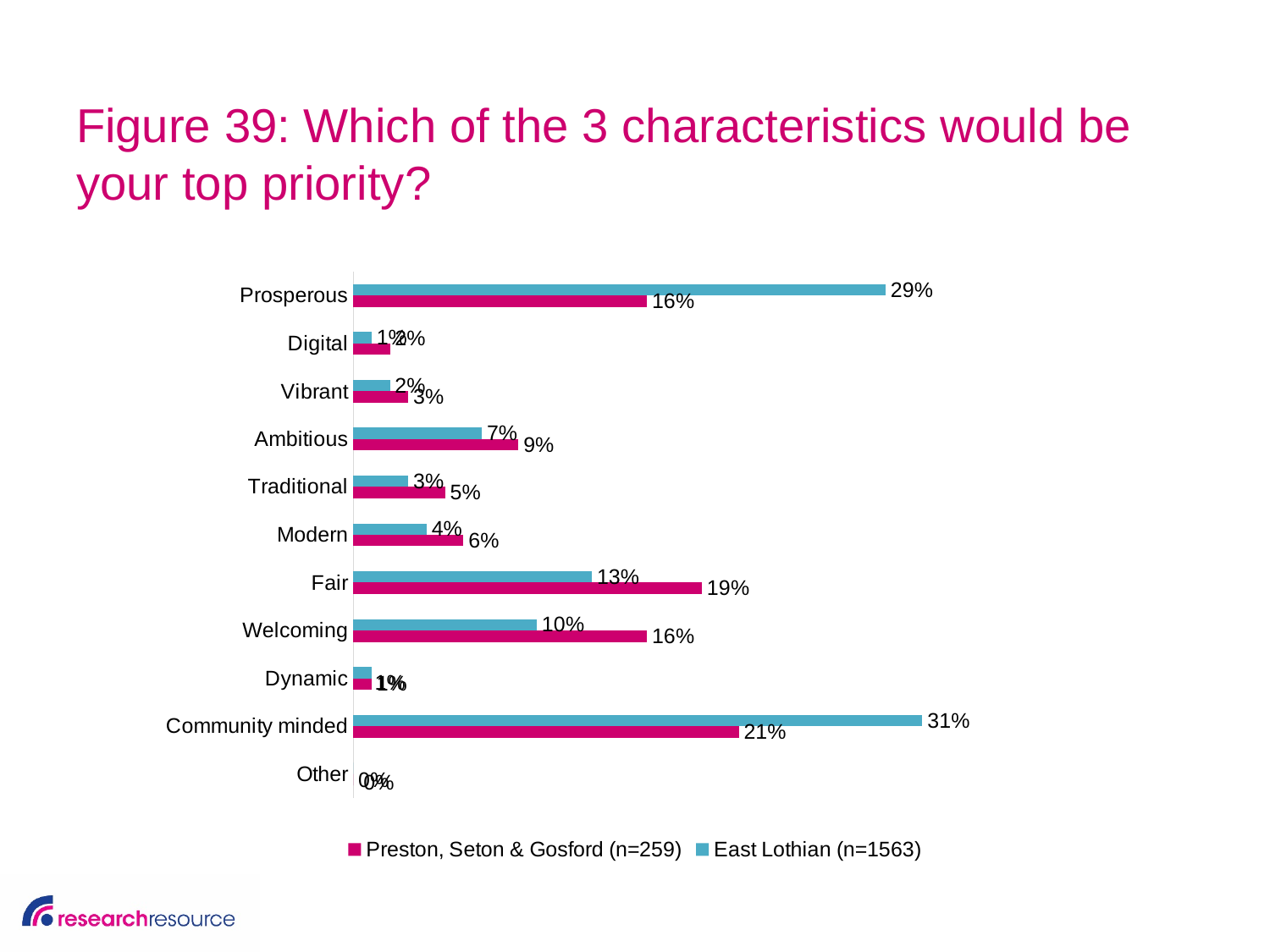
Which characteristic has the highest value for Preston, Seton & Gosford? Community minded What is the value for Welcoming in the East Lothian series? 10% What percentage of East Lothian respondents chose Community minded as their top priority? 31% What is the difference between the East Lothian and Preston, Seton & Gosford values for Prosperous? 13% What type of chart is shown on the slide? Bar chart Which characteristic has the highest value for East Lothian? Community minded How many series does the legend list? 2 For Welcoming, which series has the larger value: Preston, Seton & Gosford or East Lothian? Preston, Seton & Gosford What is the value for Ambitious in the Preston, Seton & Gosford series? 9% What percentage of Preston, Seton & Gosford respondents chose Fair as their top priority? 19% How many characteristics are listed on the chart? 11 What is the difference between the Preston, Seton & Gosford and East Lothian values for Fair? 6%